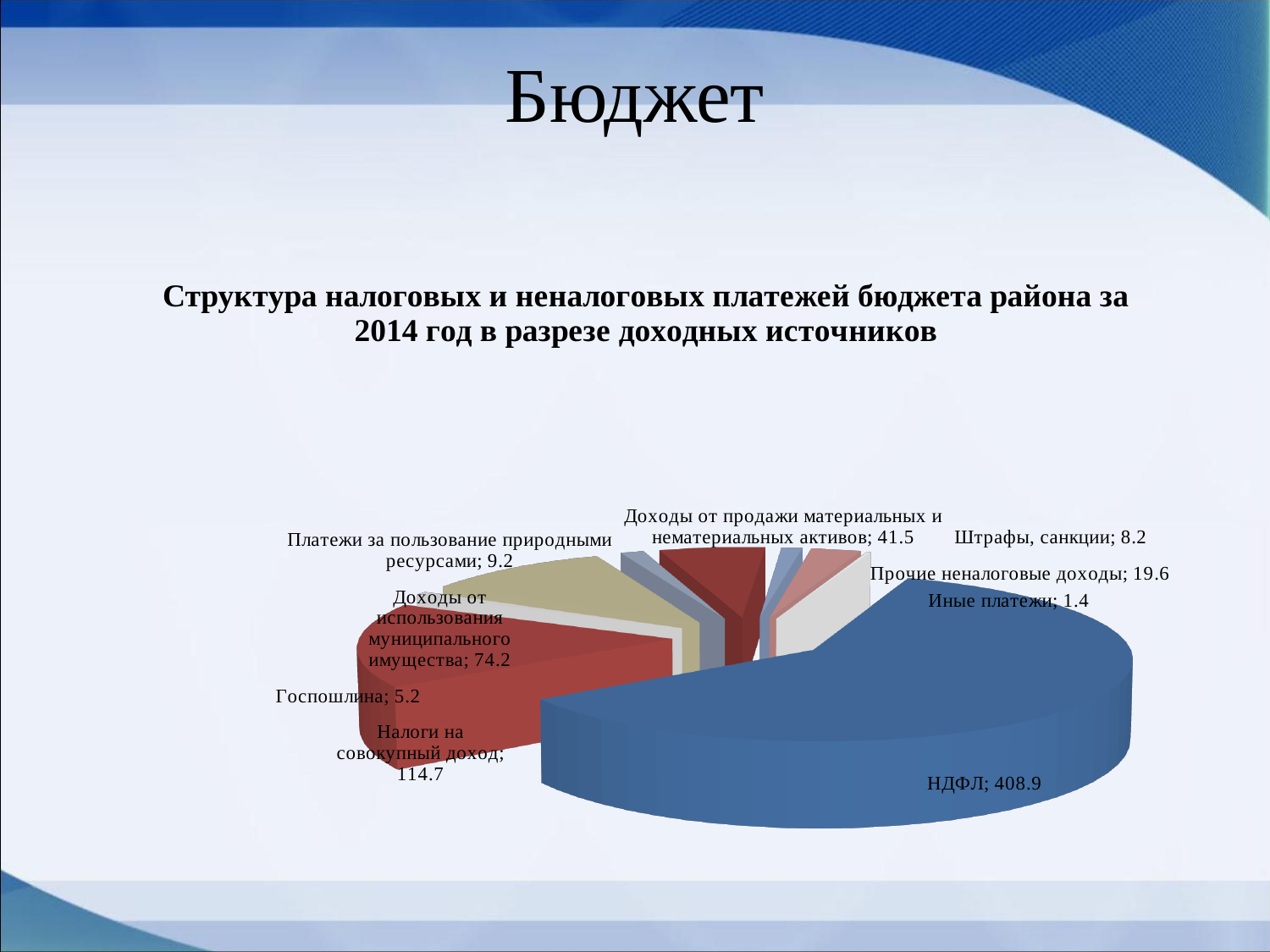
Which is larger: Доходы от использования муниципального имущества or Доходы от продажи материальных и нематериальных активов? Доходы от использования муниципального имущества What is the title of the chart on the slide? Структура налоговых и неналоговых платежей бюджета района за 2014 год в разрезе доходных источников What value is shown for Иные платежи? 1.4 What value is shown for Налоги на совокупный доход? 114.7 What value is shown for НДФЛ on the pie chart? 408.9 What kind of chart is shown on the slide? Pie chart Which category has the largest value on the pie chart? НДФЛ Which category has the smallest value on the pie chart? Иные платежи What is the difference between the values for НДФЛ and Налоги на совокупный доход? 294.2 What is the difference between Прочие неналоговые доходы and Штрафы, санкции? 11.4 What value is shown for Доходы от продажи материальных и нематериальных активов? 41.5 How many categories are shown on the pie chart? 9